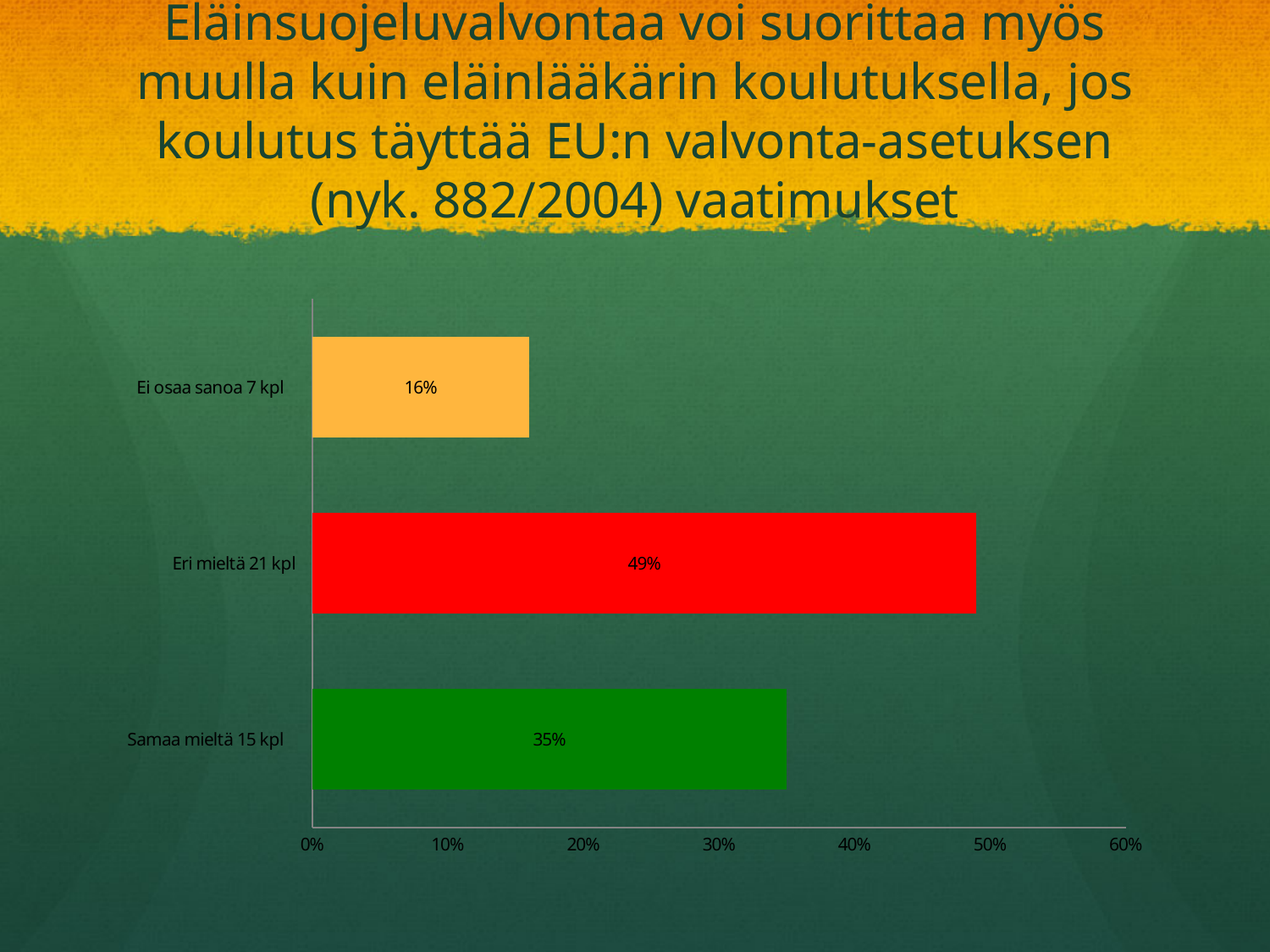
Which category has the lowest value? Ei osaa sanoa 7 kpl What kind of chart is shown on the slide? bar chart What is the value for "Ei osaa sanoa 7 kpl"? 16% What colour is the bar for "Eri mieltä 21 kpl"? red What is the value for "Samaa mieltä 15 kpl"? 35% How many categories are shown in the chart? 3 What is the difference between the values for "Eri mieltä 21 kpl" and "Samaa mieltä 15 kpl"? 14% Is the value for "Eri mieltä 21 kpl" greater or less than 40%? greater Which is larger, the value for "Samaa mieltä 15 kpl" or the value for "Ei osaa sanoa 7 kpl"? Samaa mieltä 15 kpl What is the difference between the values for "Samaa mieltä 15 kpl" and "Ei osaa sanoa 7 kpl"? 19% Which category has the highest value? Eri mieltä 21 kpl What is the value for "Eri mieltä 21 kpl"? 49%